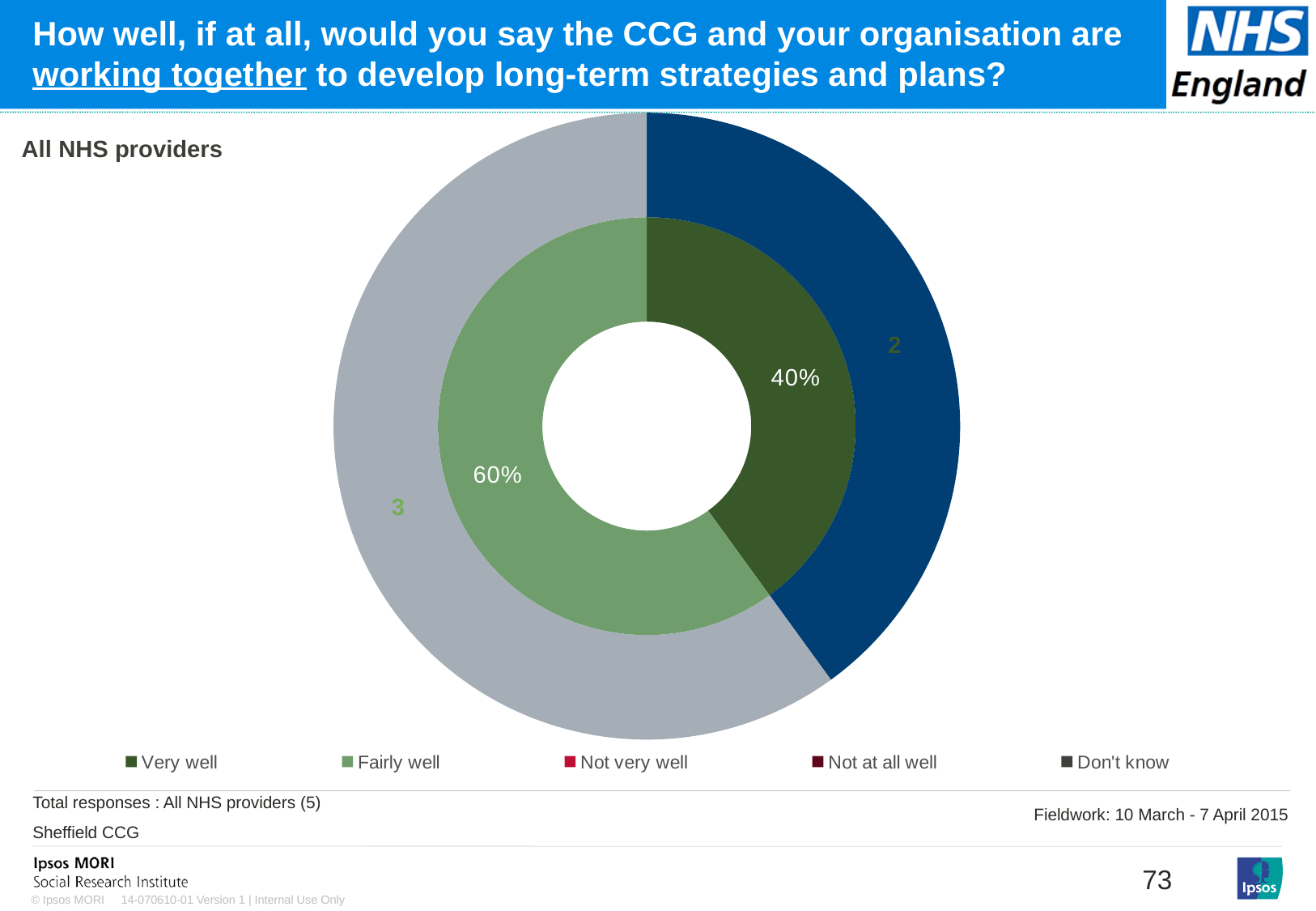
What percentage of respondents said 'Very well'? 40% What number is shown on the outer ring segment corresponding to 'Very well'? 2 What is the difference in percentage points between 'Fairly well' and 'Very well'? 20 What number is shown on the outer ring segment corresponding to 'Fairly well'? 3 Which response category has the smallest non-zero share shown in the inner ring? Very well Which response category has the largest share in the inner ring? Fairly well What group does the chart cover, according to the label at the top left? All NHS providers What kind of chart is shown on the slide? Doughnut chart What percentage of respondents said 'Fairly well'? 60% How many response categories does the legend list? 5 What is the combined percentage of 'Very well' and 'Fairly well'? 100% Which is larger, the share for 'Very well' or the share for 'Fairly well'? Fairly well